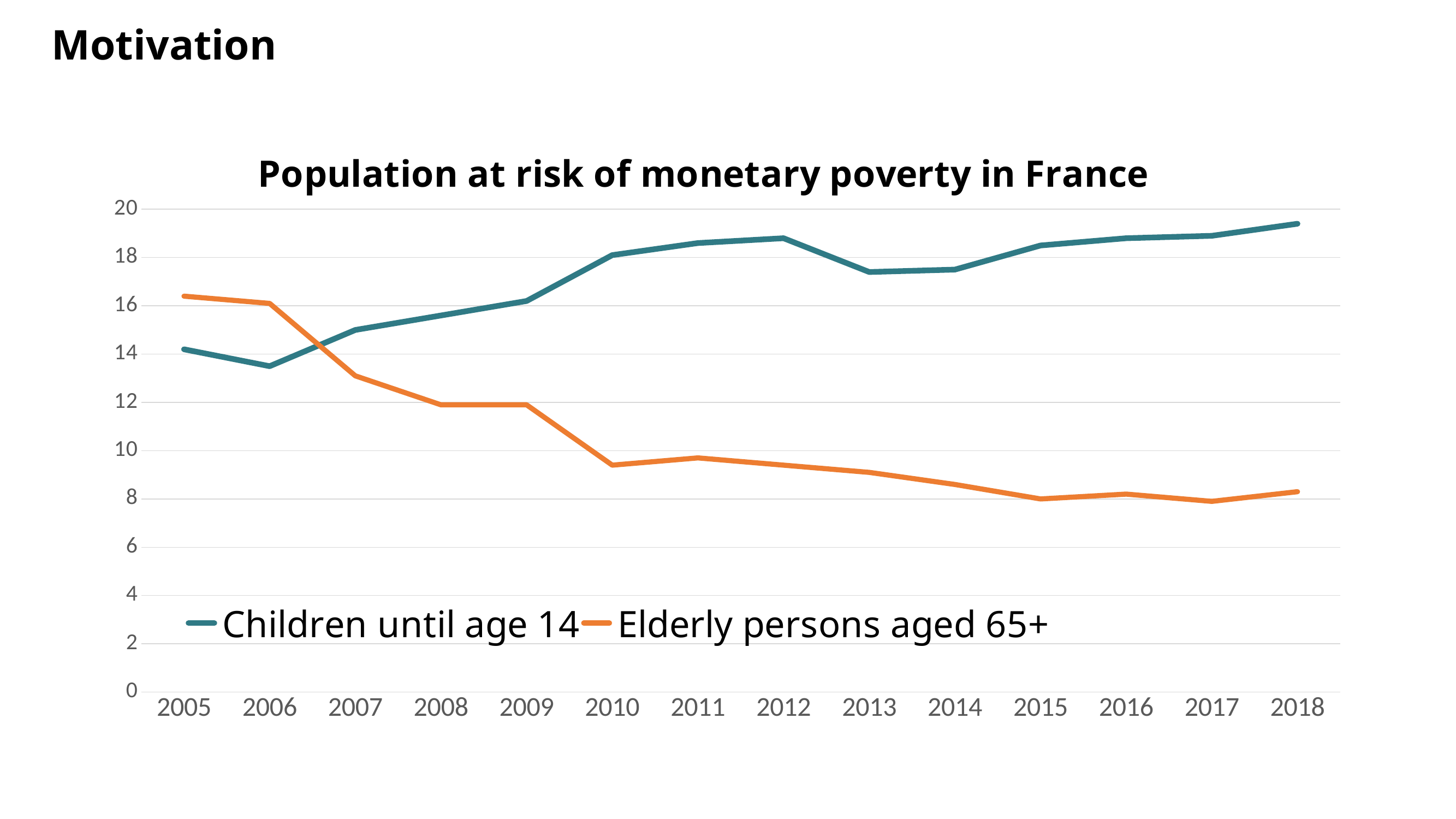
In 2005, which series has the larger value, Children until age 14 or Elderly persons aged 65+? Elderly persons aged 65+ In which year is the value for Children until age 14 highest? 2018 Overall, do the values for Elderly persons aged 65+ rise or fall from 2005 to 2018? fall Is the value for Elderly persons aged 65+ in 2015 greater or less than 10? less What kind of chart is shown on the slide? line chart What is the title of the chart? Population at risk of monetary poverty in France How many series does the legend list? 2 In 2018, which series has the larger value, Children until age 14 or Elderly persons aged 65+? Children until age 14 Which series is drawn in orange? Elderly persons aged 65+ How many years are plotted along the x axis? 14 Overall, do the values for Children until age 14 rise or fall from 2005 to 2018? rise In which year is the value for Children until age 14 lowest? 2006